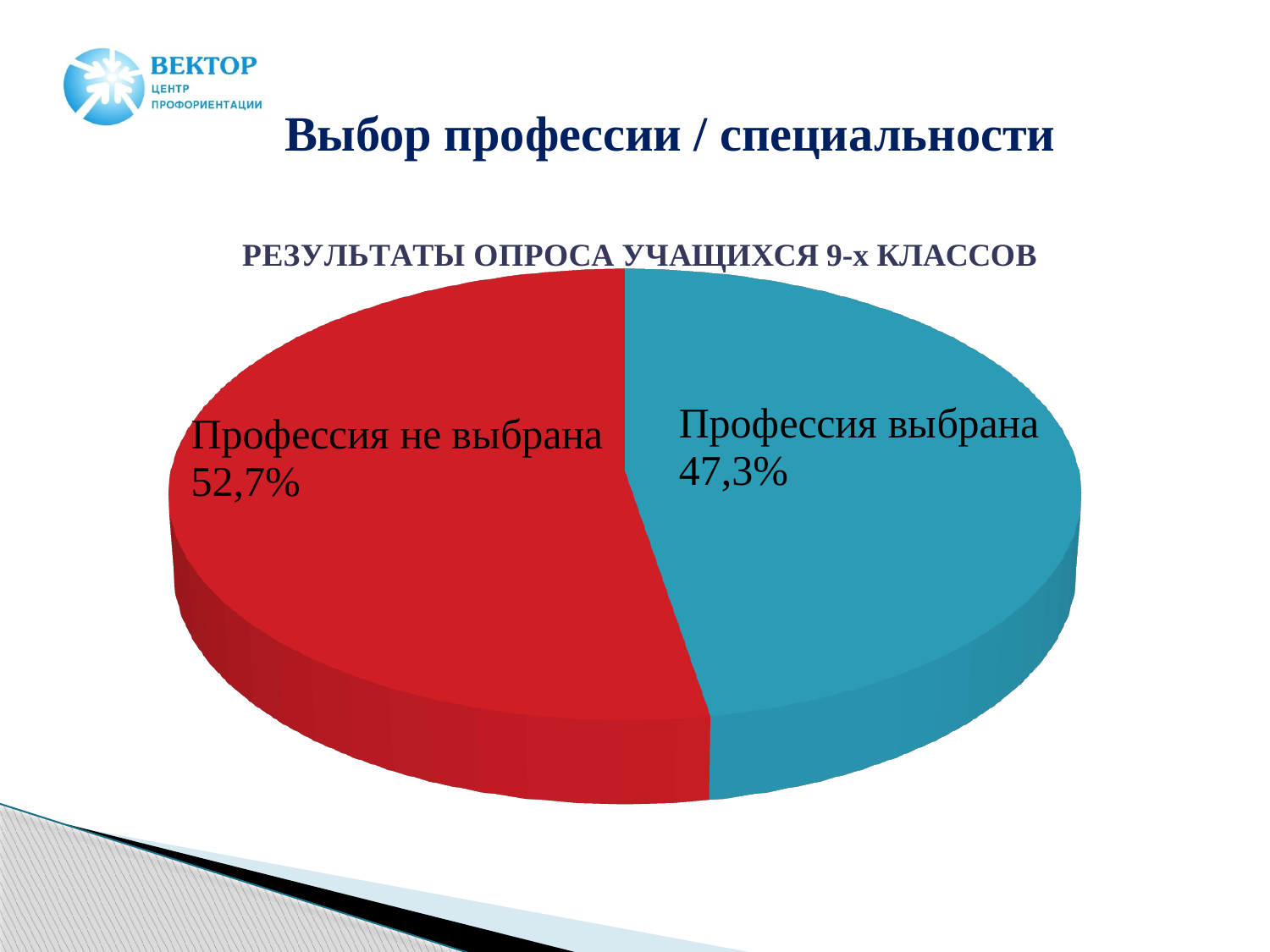
What is the value for "Профессия выбрана"? 47,3% What is the title of the chart? РЕЗУЛЬТАТЫ ОПРОСА УЧАЩИХСЯ 9-х КЛАССОВ Which slice is the largest? Профессия не выбрана Which slice is the smallest? Профессия выбрана What is the value for "Профессия не выбрана"? 52,7% What kind of chart is shown on the slide? pie chart Which is larger: "Профессия выбрана" or "Профессия не выбрана"? Профессия не выбрана What share of the pie does "Профессия выбрана" represent? 47,3% What colour is the "Профессия выбрана" slice? blue What is the difference between "Профессия не выбрана" and "Профессия выбрана"? 5,4% How many slices does the pie chart have? 2